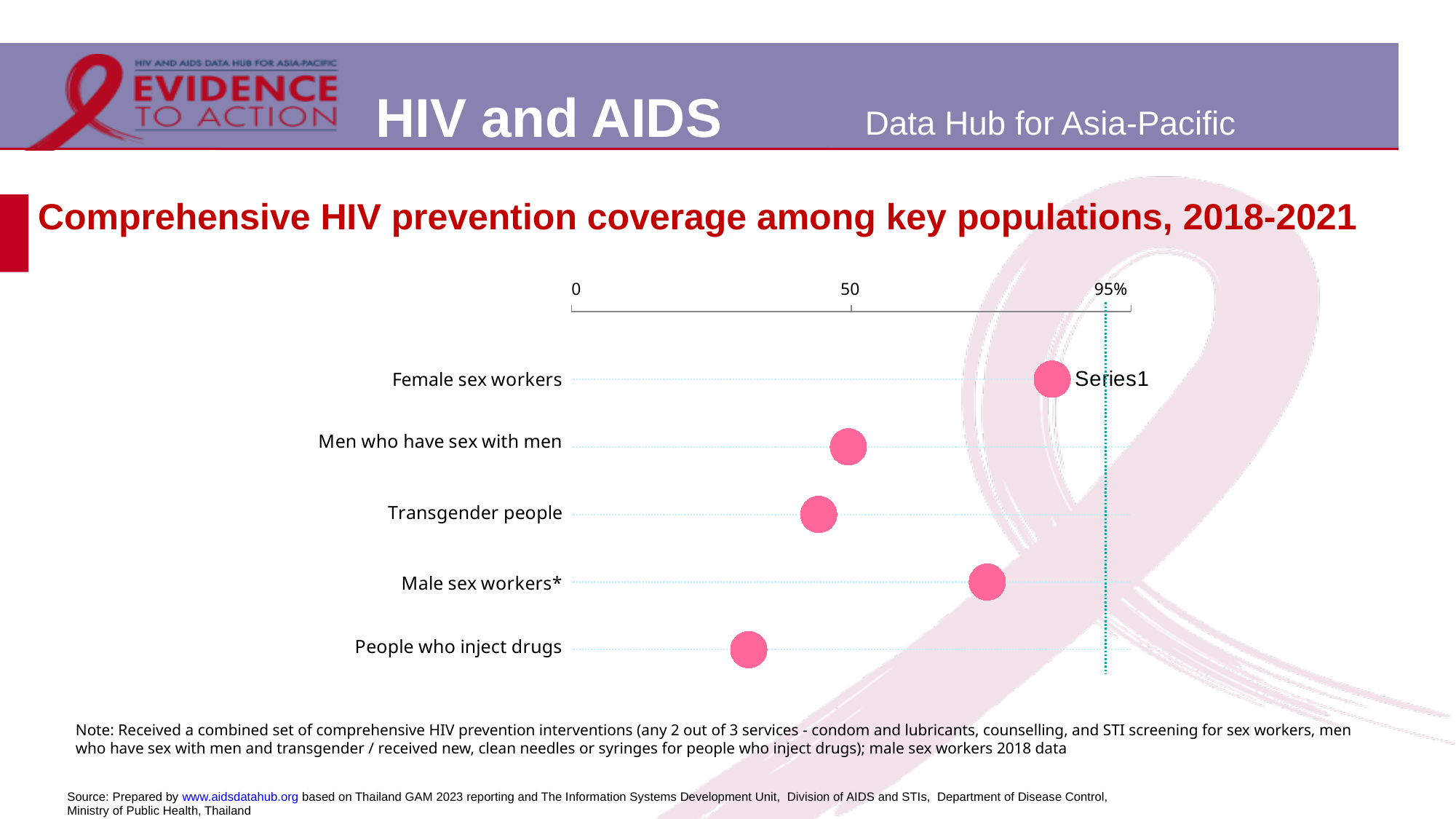
Is the value for Male sex workers* greater or less than 50? greater Which has higher coverage: Men who have sex with men or People who inject drugs? Men who have sex with men What kind of chart is shown on the slide? Dot plot How many key populations are plotted on the chart? 5 Which key population has the lowest comprehensive HIV prevention coverage on the chart? People who inject drugs Is the value for Female sex workers greater or less than 50? greater Which key population has the highest comprehensive HIV prevention coverage on the chart? Female sex workers Which has higher coverage: Female sex workers or Male sex workers*? Female sex workers Is the value for Female sex workers greater or less than 95%? less Which has higher coverage: Transgender people or Male sex workers*? Male sex workers* What is the title of the chart on the slide? Comprehensive HIV prevention coverage among key populations, 2018-2021